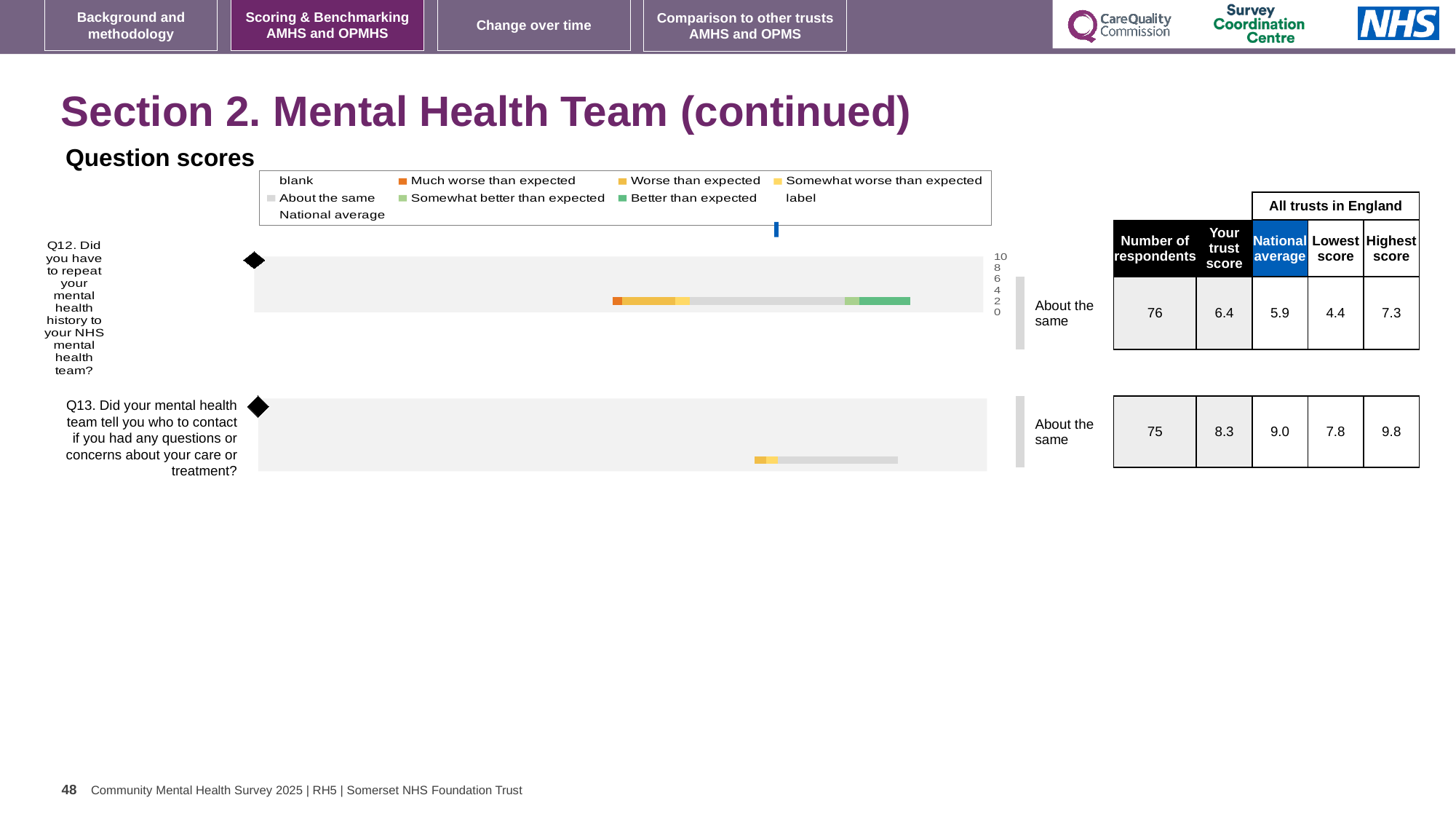
What is the trust score for Q12 (Did you have to repeat your mental health history to your NHS mental health team?)? 6.4 What type of chart is used to show the question scores? Bar chart What is the difference between the highest and lowest scores for Q13? 2.0 What is the national average score for Q13 (Did your mental health team tell you who to contact if you had any questions or concerns about your care or treatment?)? 9.0 How many questions are plotted on the chart? 2 Which is larger for Q13, the trust score or the national average? National average What benchmark category is shown for Q12? About the same How many respondents answered Q12? 76 What is the lowest score among all trusts in England for Q12? 4.4 What is the highest score among all trusts in England for Q13? 9.8 Which question has the higher trust score, Q12 or Q13? Q13 What is the difference between the trust score and the national average for Q12? 0.5